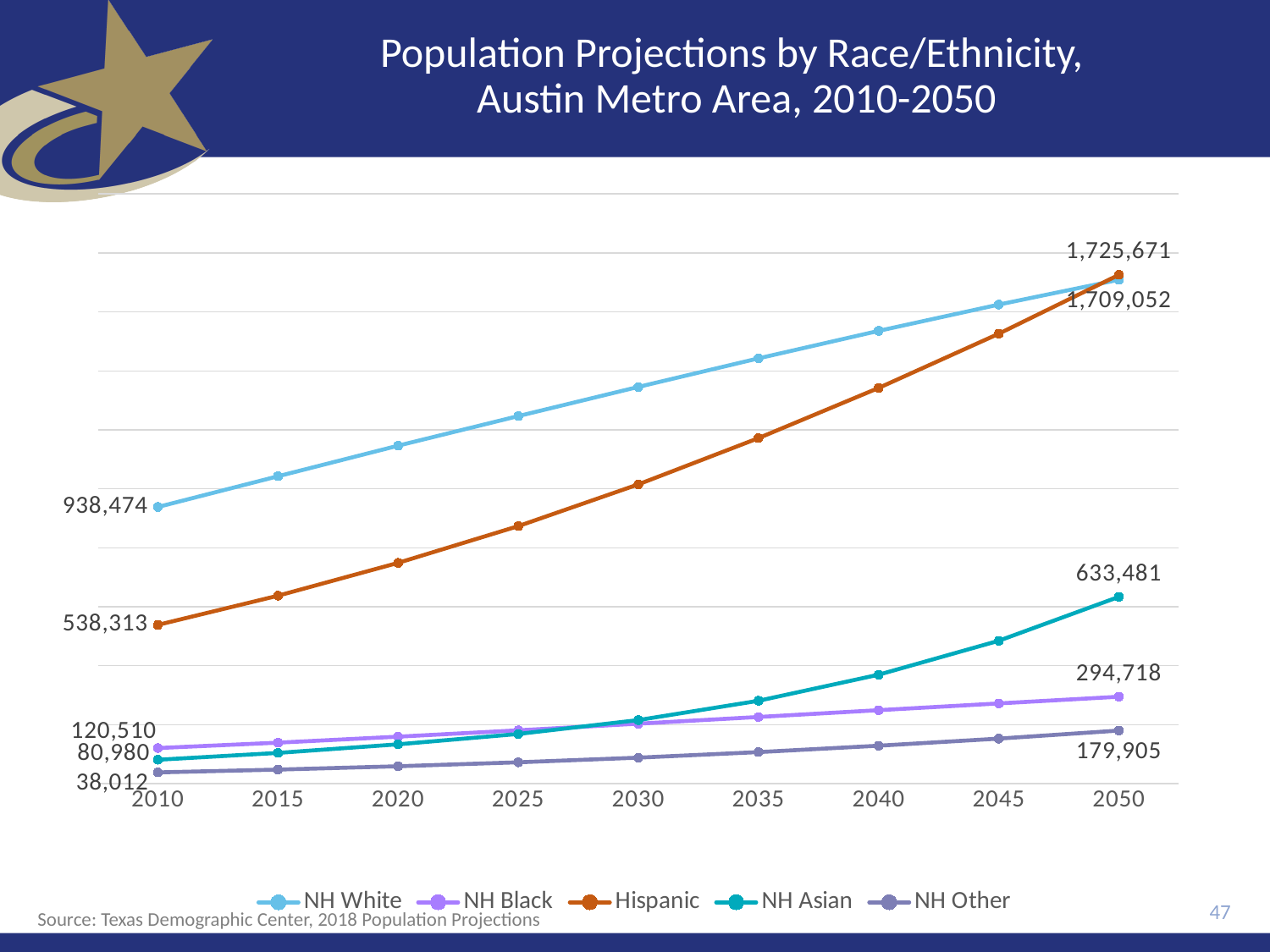
What is the projected Hispanic population in 2050? 1,725,671 Does the NH Asian population rise or fall from 2010 to 2050? Rise Which race/ethnicity group has the lowest projected population in 2010? NH Other By how much is the Hispanic population projected to grow from 2010 to 2050? 1,187,358 What is the difference between the Hispanic and NH White projected populations in 2050? 16,619 What is the projected NH Asian population in 2050? 633,481 In 2010, which is larger: the NH Black population or the NH Asian population? NH Black What is the projected NH Other population in 2010? 38,012 How many series does the legend list? 5 Which race/ethnicity group has the highest projected population in 2050? Hispanic What kind of chart is shown on the slide? Line chart What is the projected NH White population in 2010? 938,474